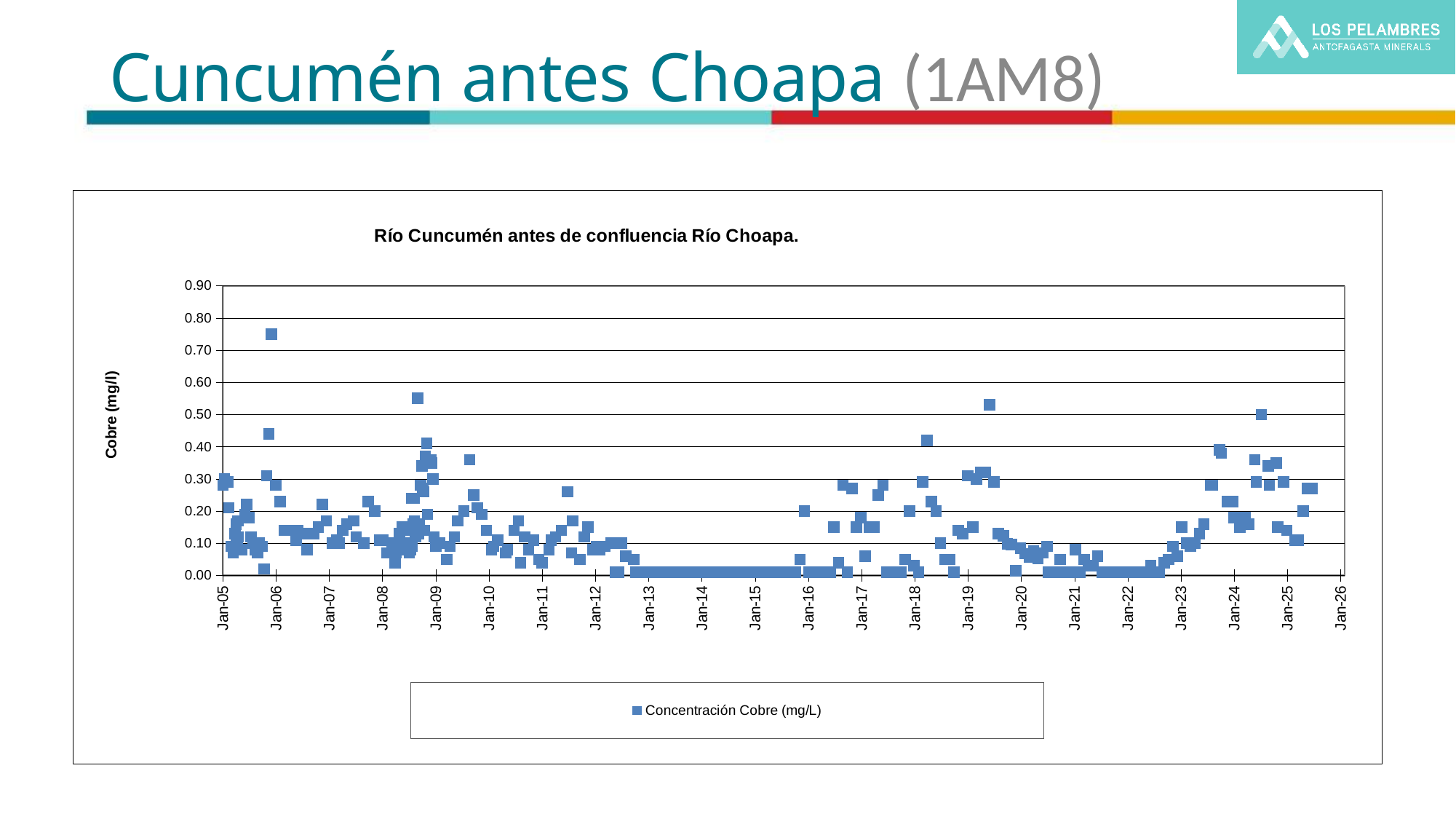
What is the highest value shown on the vertical axis? 0.90 What is the first date label on the horizontal axis? Jan-05 How many series does the chart legend list? 1 What is the label of the vertical axis? Cobre (mg/l) What is the name of the series shown in the legend? Concentración Cobre (mg/L) What kind of chart is shown on the slide? scatter chart Are the plotted values between Jan-13 and Jan-15 greater or less than 0.10? less What is the last date label on the horizontal axis? Jan-26 What is the title of the chart? Río Cuncumén antes de confluencia Río Choapa. How many date labels are shown on the horizontal axis? 22 Is the highest plotted copper concentration greater or less than 0.70? greater Is the highest plotted copper concentration greater or less than 0.80? less